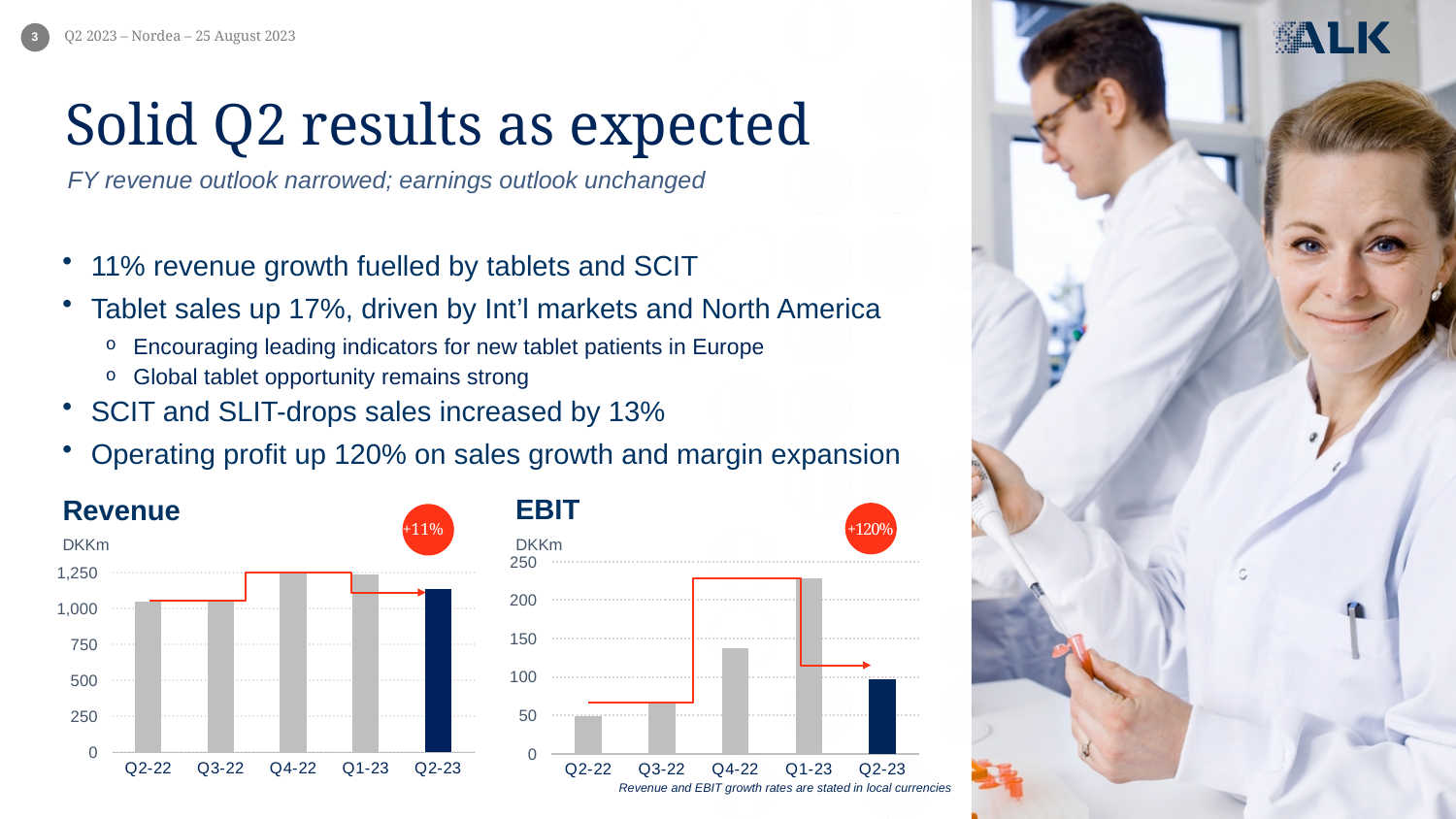
What growth rate is shown in the red circle on the Revenue chart? +11% On the Revenue chart, which is larger, Q4-22 or Q2-22? Q4-22 On the EBIT chart, which quarter has the lowest value? Q2-22 On the EBIT chart, is the value for Q1-23 greater or less than 200? greater What type of chart is the Revenue chart? bar chart On the EBIT chart, which quarter has the highest value? Q1-23 How many quarters are shown on the Revenue chart? 5 On the Revenue chart, is the value for Q2-23 greater or less than 1,000? greater What unit is shown on the EBIT chart's axis? DKKm On the EBIT chart, which is larger, Q4-22 or Q2-23? Q4-22 On the EBIT chart, is the value for Q4-22 greater or less than 100? greater